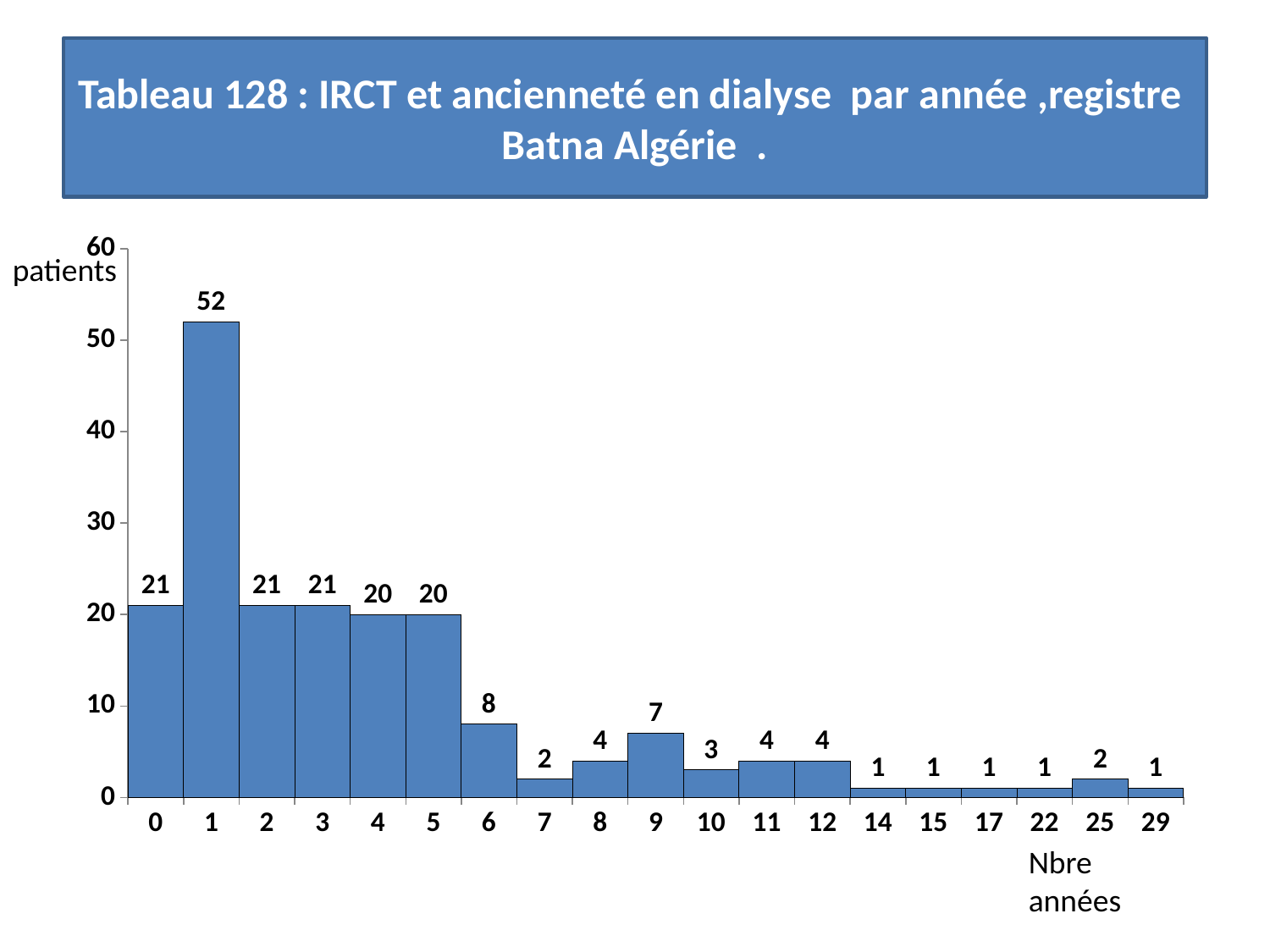
What is the difference between the values for 6 years and 7 years? 6 What is the difference in patients between 1 year and 0 years? 31 Is the value for 1 year greater or less than 50? greater Which number of years has the highest number of patients? 1 What is the value for 25 years? 2 Which has more patients, 9 years or 10 years? 9 years How many patients are shown for 9 years? 7 What kind of chart is shown on the slide? Bar chart What is the number of patients for 6 years of dialysis? 8 How many patients are shown for 1 year of dialysis? 52 What is the label of the x axis? Nbre années How many categories (numbers of years) are shown on the x axis? 19